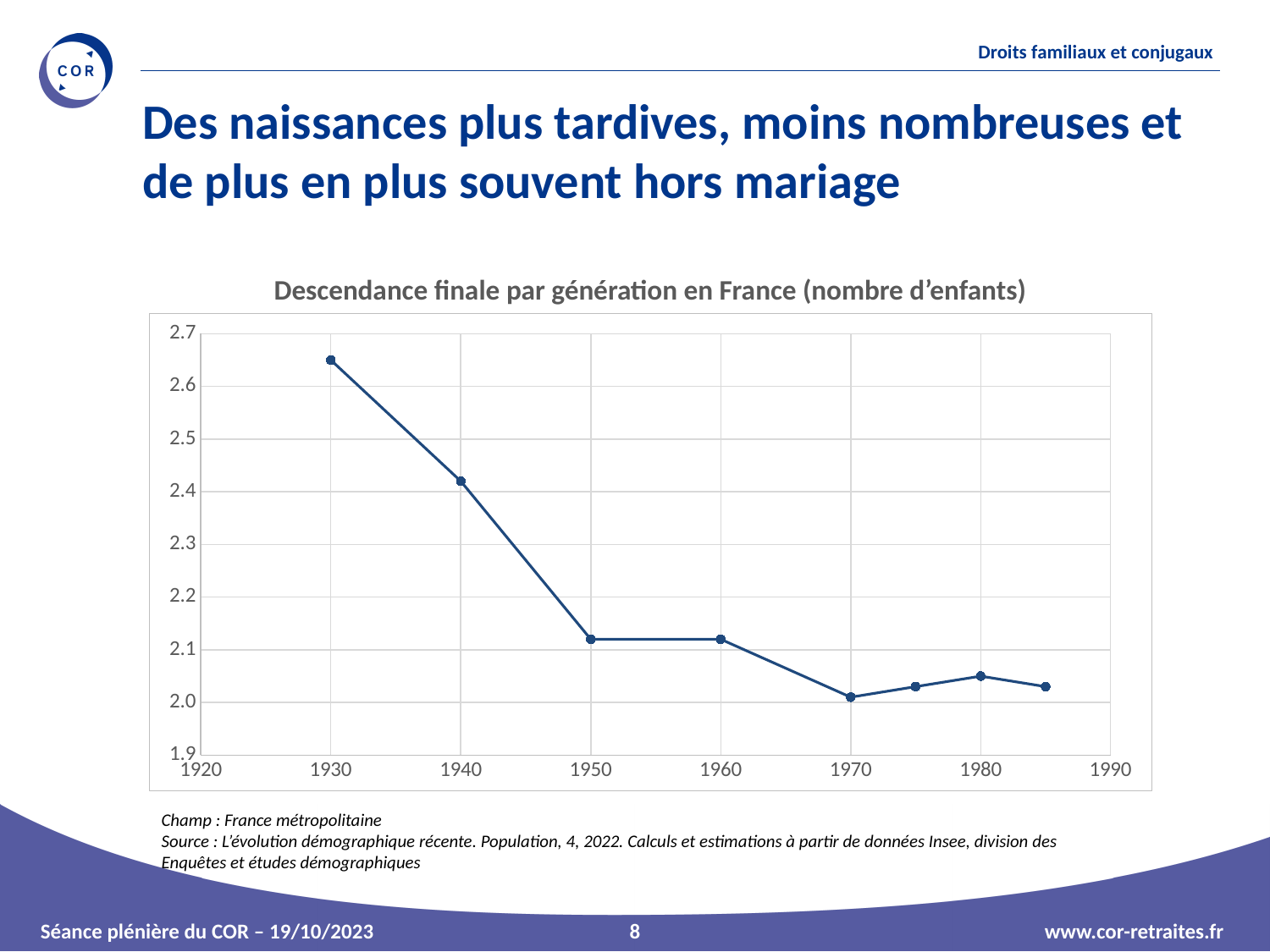
Is the value for the 1930 generation greater or less than 2.6? greater Is the value for the 1950 generation greater or less than 2.2? less Which generation has the larger value, 1940 or 1970? 1940 What kind of chart is shown on the slide? line chart Which generation has the larger value, 1930 or 1940? 1930 Is the value for the 1940 generation greater or less than 2.3? greater How many data points are plotted on the line? 8 What is the title of the chart? Descendance finale par génération en France (nombre d'enfants) Overall, do the values rise or fall from the 1930 generation to the 1985 generation? fall Which generation has the highest descendance finale? 1930